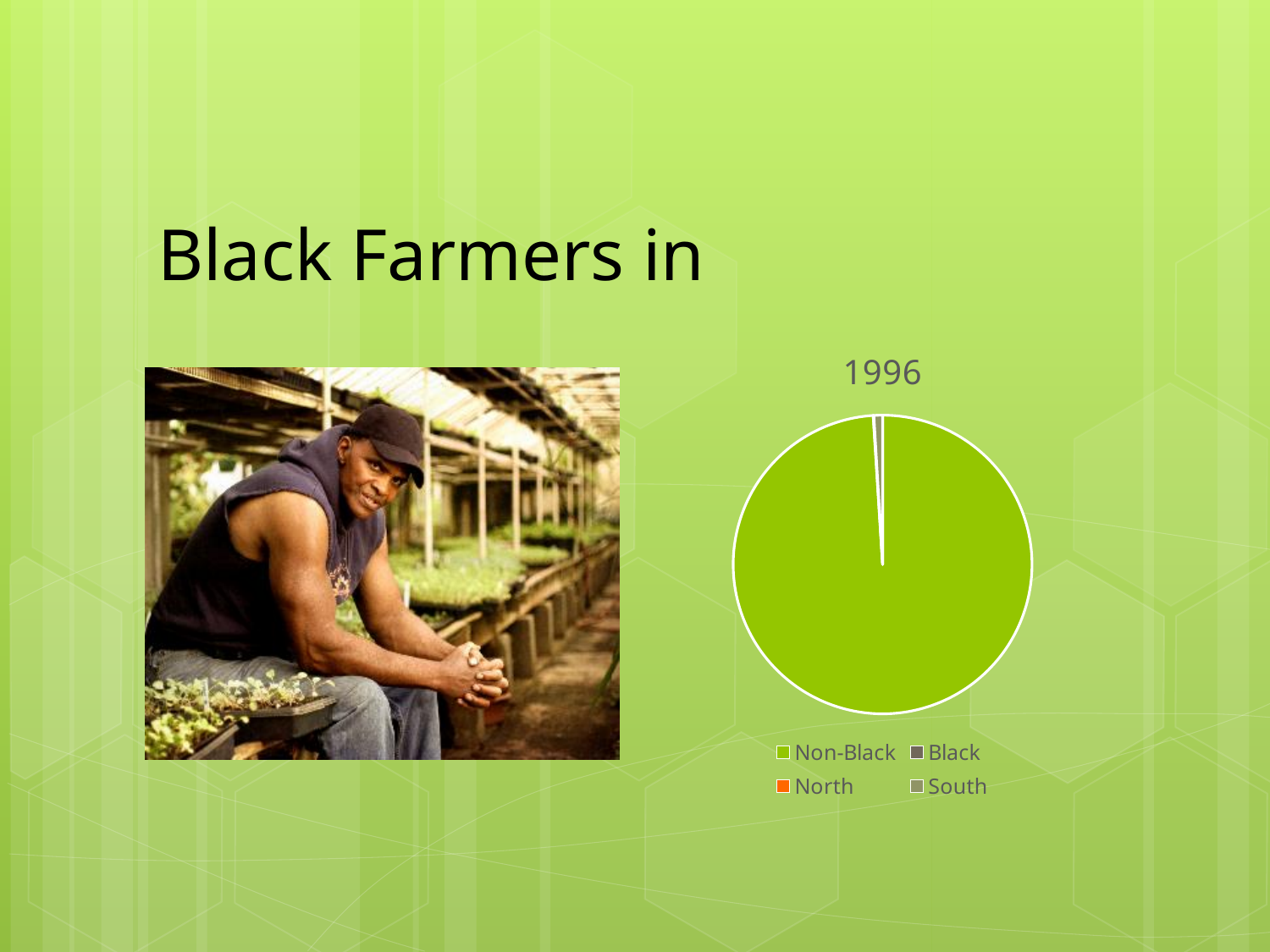
In the 1996 pie chart, which is larger, the Non-Black slice or the Black slice? Non-Black Does the Non-Black slice take up more or less than half of the 1996 pie chart? more Which legend entry is shown in green in the 1996 pie chart? Non-Black What kind of chart is shown on the slide? pie chart Which category has the largest slice in the 1996 pie chart? Non-Black How many entries does the legend of the pie chart list? 4 What is the title of the pie chart? 1996